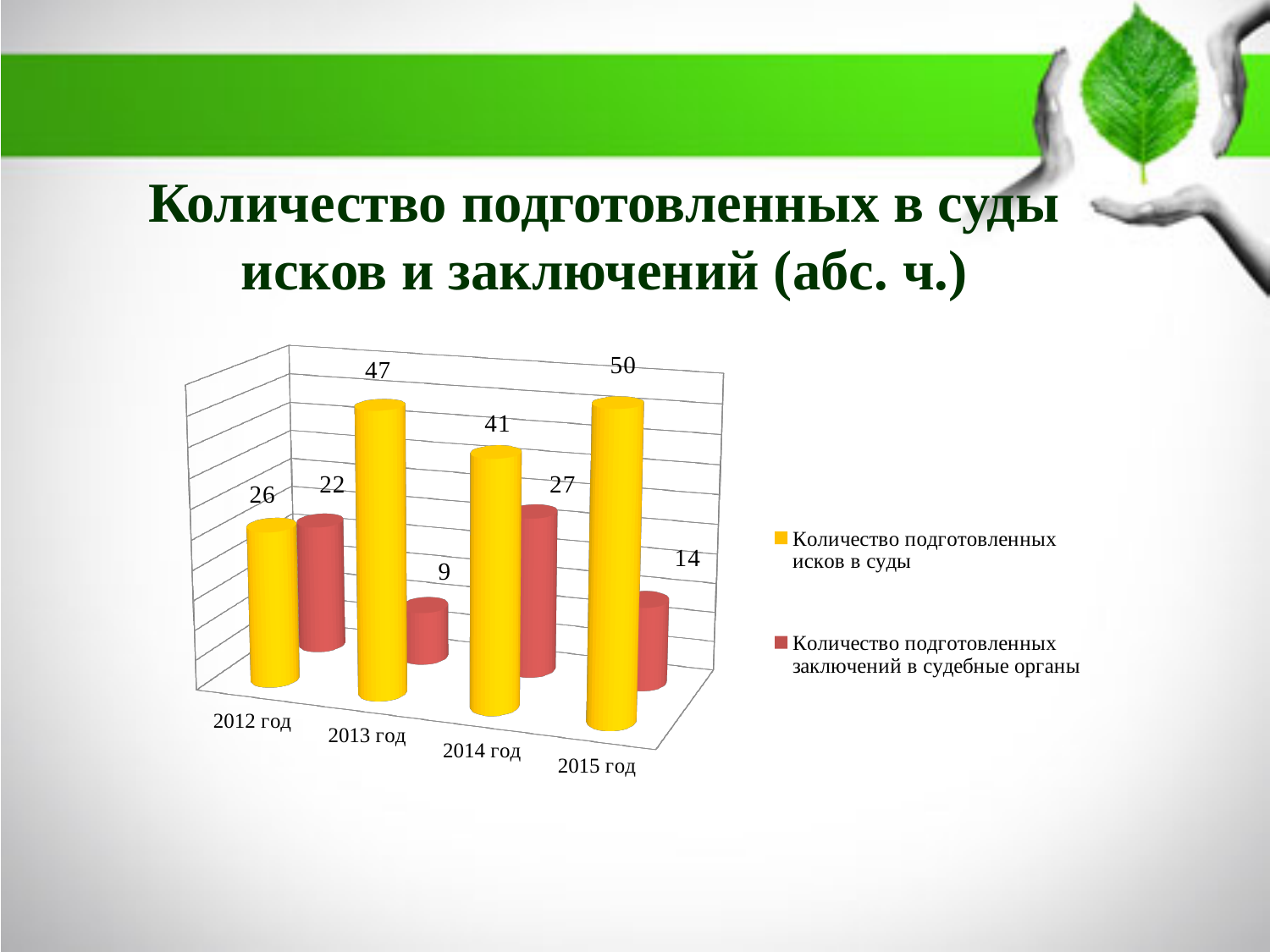
What kind of chart is shown on the slide? Bar chart How many series does the chart legend list? 2 What is the value for 'Количество подготовленных заключений в судебные органы' in 2014 год? 27 In which year is 'Количество подготовленных заключений в судебные органы' lowest? 2013 год In which year is 'Количество подготовленных исков в суды' highest? 2015 год What colour are the bars for 'Количество подготовленных заключений в судебные органы'? Red What is the value for 'Количество подготовленных исков в суды' in 2013 год? 47 What is the difference between 'Количество подготовленных исков в суды' and 'Количество подготовленных заключений в судебные органы' in 2015 год? 36 What is the value for 'Количество подготовленных исков в суды' in 2012 год? 26 How many years are shown on the x axis of the chart? 4 Did 'Количество подготовленных исков в суды' rise or fall from 2013 год to 2014 год? Fall Which is larger in 2012 год: 'Количество подготовленных исков в суды' or 'Количество подготовленных заключений в судебные органы'? Количество подготовленных исков в суды